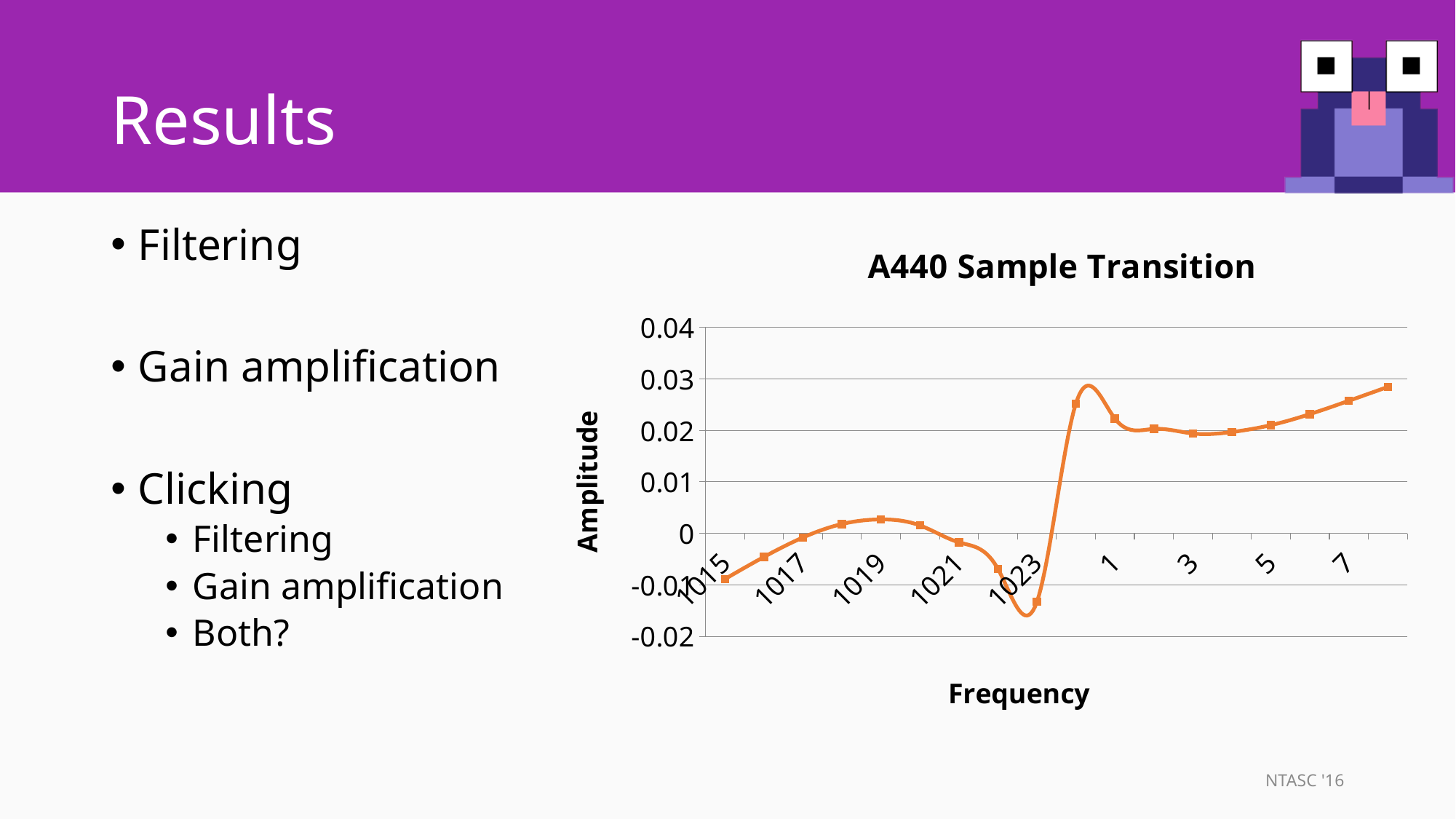
Which has the larger amplitude, frequency 1023 or frequency 1019? 1019 Is the amplitude at frequency 3 greater or less than 0.01? greater Does the amplitude rise or fall between frequency 3 and frequency 7? rise Is the amplitude at frequency 5 greater or less than 0.03? less Is the amplitude at frequency 1015 greater or less than 0? less What is the title of the chart? A440 Sample Transition Which has the larger amplitude, frequency 1015 or frequency 7? 7 Among the labeled frequencies on the x axis, which has the lowest amplitude? 1023 What is the label of the vertical axis of the chart? Amplitude What kind of chart is shown on the slide? line chart